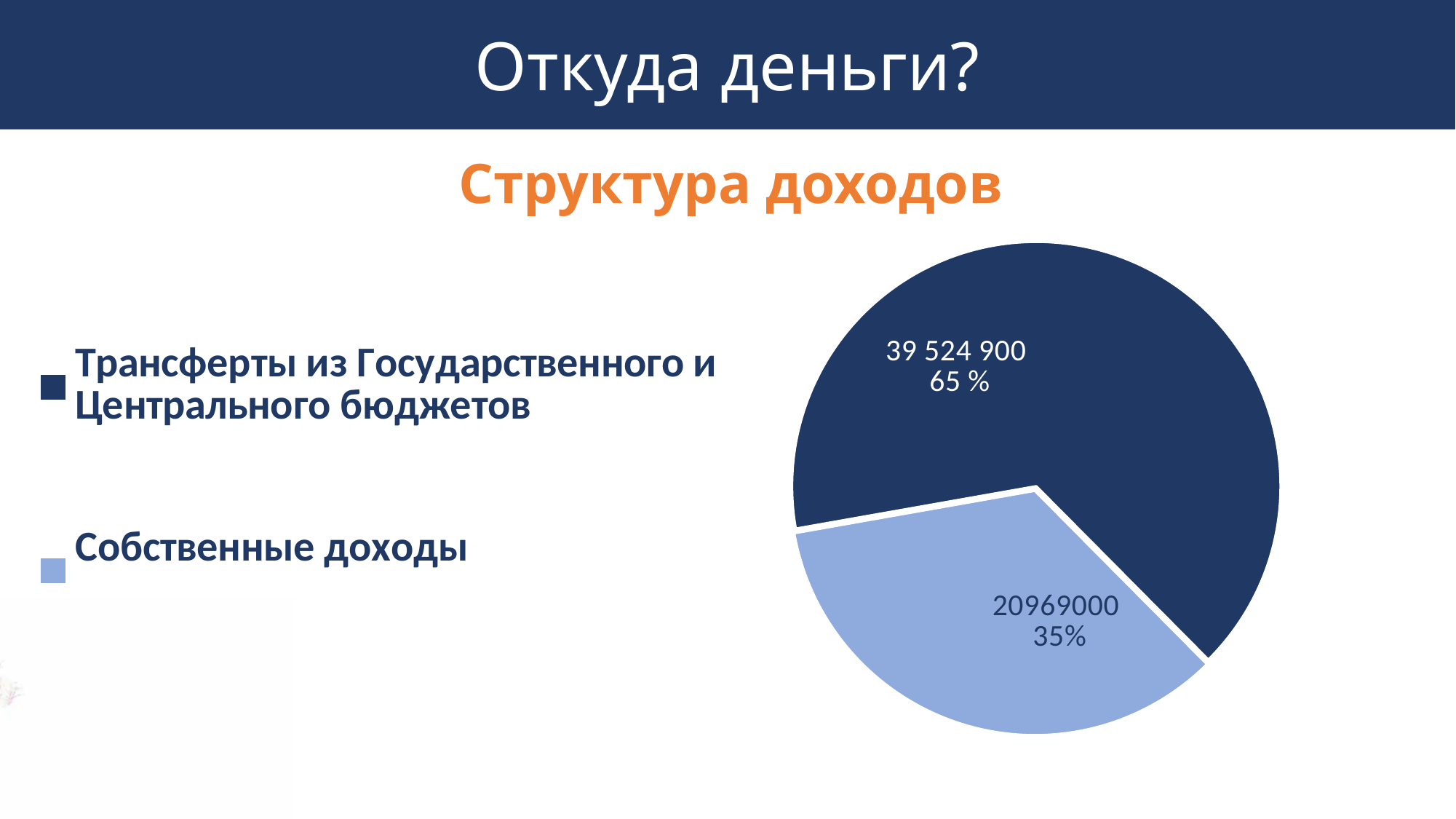
How many slices does the pie chart have? 2 Which colour represents Собственные доходы in the legend? light blue Which category has the smallest slice of the pie? Собственные доходы What is the value shown for Собственные доходы? 20969000 What is the title of the chart? Структура доходов Which is larger, Трансферты из Государственного и Центрального бюджетов or Собственные доходы? Трансферты из Государственного и Центрального бюджетов Which category has the largest slice of the pie? Трансферты из Государственного и Центрального бюджетов What kind of chart is shown on the slide? pie chart What share of the pie is Трансферты из Государственного и Центрального бюджетов? 65 % What is the value shown for Трансферты из Государственного и Центрального бюджетов? 39 524 900 What share of the pie is Собственные доходы? 35% What is the difference between the values for Трансферты из Государственного и Центрального бюджетов and Собственные доходы? 18 555 900